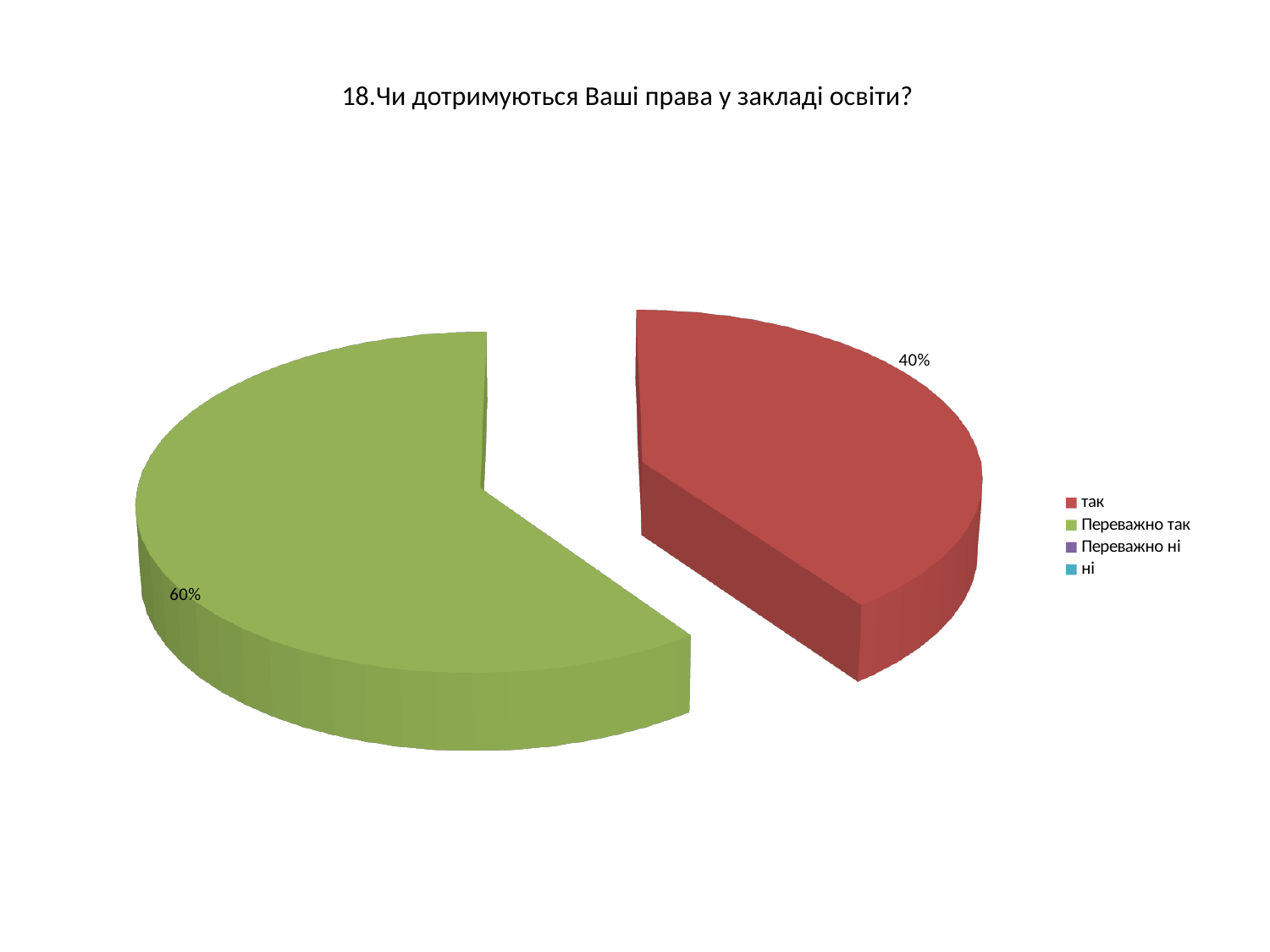
What is the value for "так"? 40% How many entries does the legend list? 4 What colour is the slice for "Переважно так"? green Which of the two visible slices is larger, "так" or "Переважно так"? Переважно так What kind of chart is shown on the slide? pie chart What share of the pie does "так" take? 40% What is the value for "Переважно так"? 60% What is the title of the chart? 18.Чи дотримуються Ваші права у закладі освіти? How many slices are visible in the pie? 2 Which category has the largest slice? Переважно так What is the difference between the values for "Переважно так" and "так"? 20%